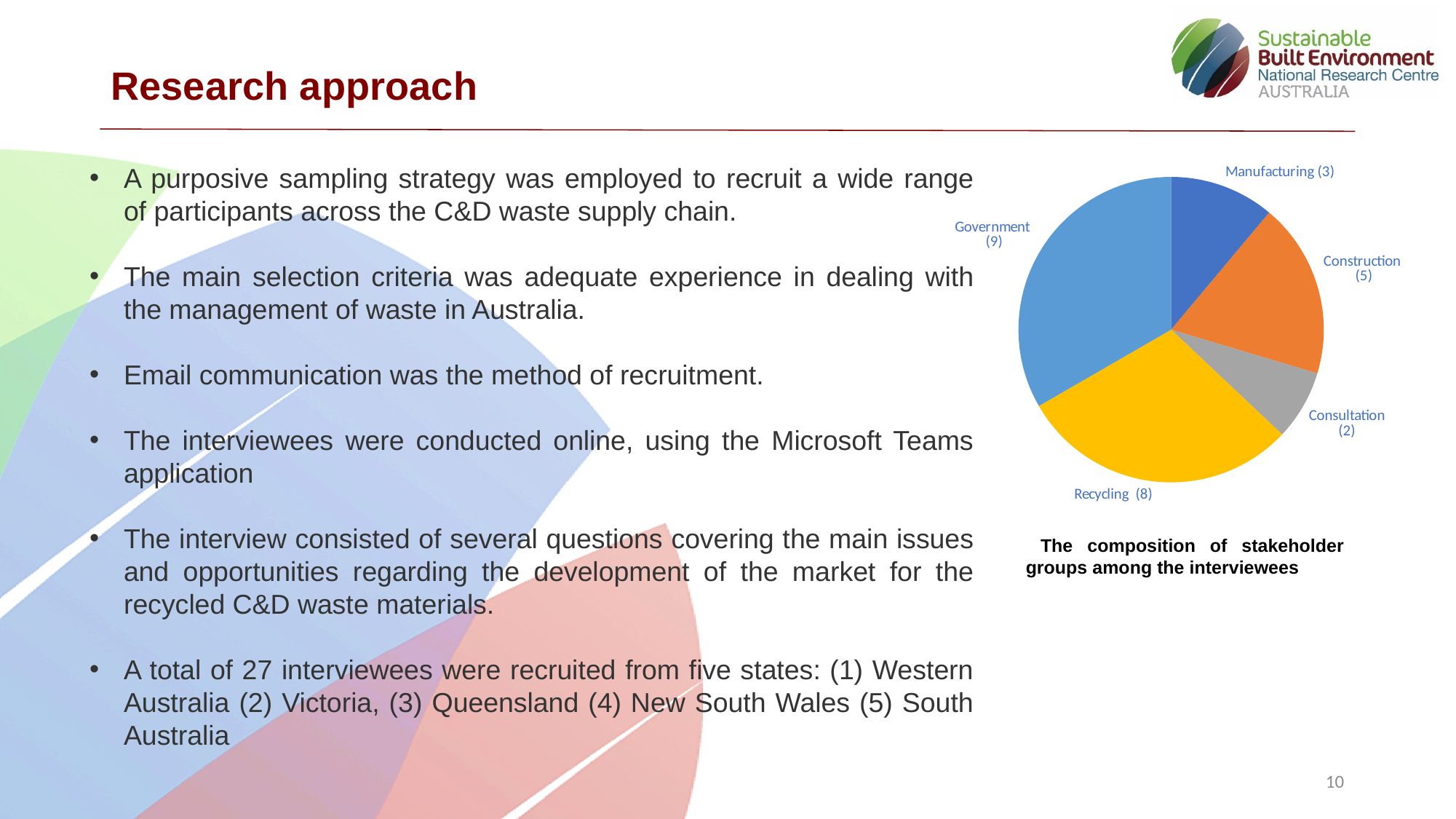
How many interviewees are in the Government stakeholder group? 9 Which stakeholder group has the smallest slice of the pie? Consultation Which stakeholder group has the largest slice of the pie? Government How many interviewees are in the Construction stakeholder group? 5 How many stakeholder groups are shown in the pie chart? 5 How many interviewees are in the Recycling stakeholder group? 8 What is the difference between the number of Government and Manufacturing interviewees? 6 Which group has more interviewees, Construction or Manufacturing? Construction How many interviewees are in the Consultation stakeholder group? 2 What kind of chart is shown on the slide? pie chart What share of the interviewees does the Recycling group represent? 8 of 27 What is the caption of the pie chart? The composition of stakeholder groups among the interviewees